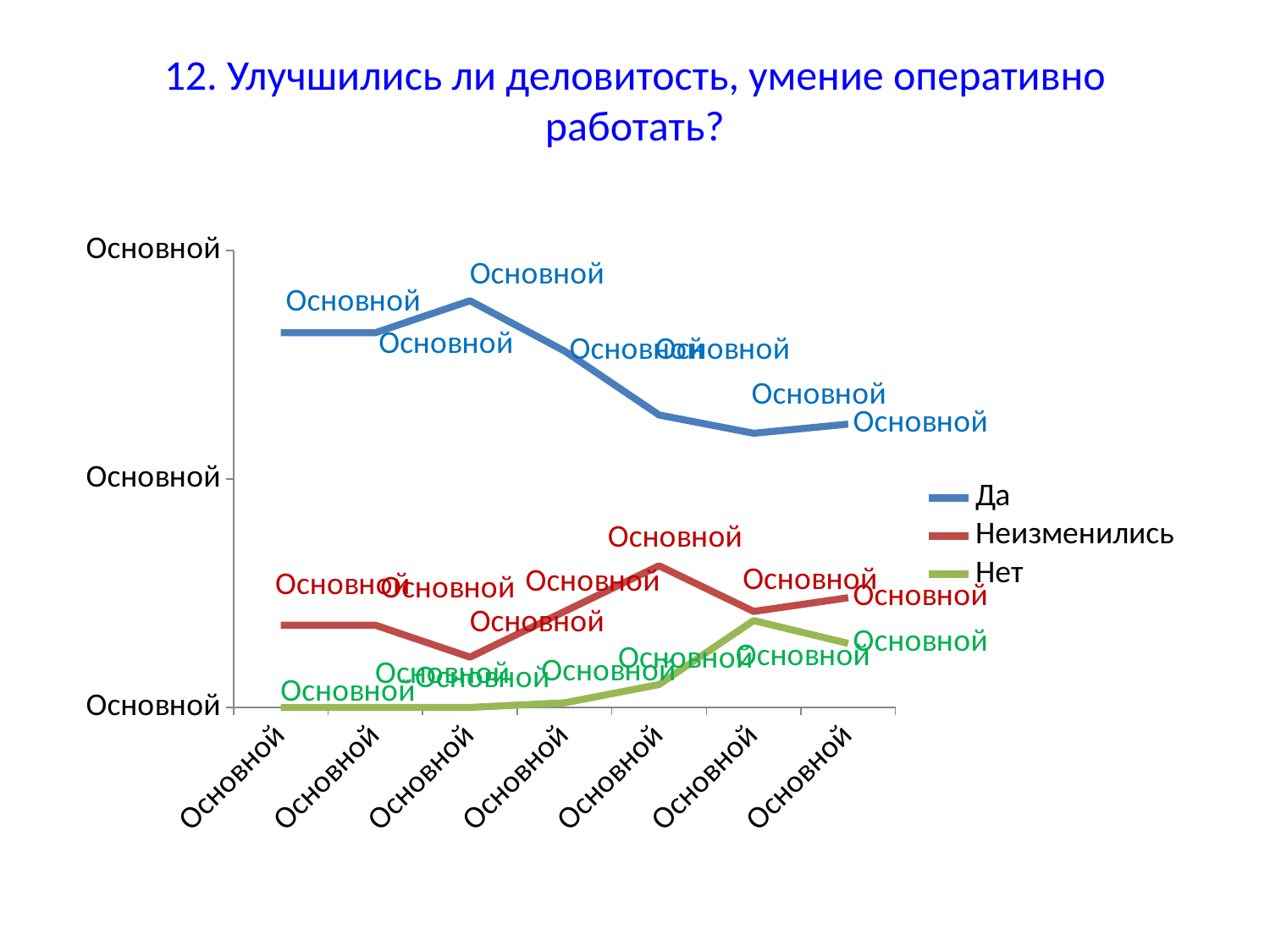
How many data points does each line have? 7 Which series has the lowest values across the chart? Нет What are the series names listed in the legend? Да, Неизменились, Нет How many series does the legend list? 3 Does the line for Да rise or fall overall from left to right? fall Does the line for Нет rise or fall overall from left to right? rise At the first point on the x axis, which is larger: Неизменились or Нет? Неизменились At the last point on the x axis, which is larger: Да or Неизменились? Да Which series has the highest values across the chart? Да What is the title of the slide above the chart? 12. Улучшились ли деловитость, умение оперативно работать? Which series is drawn in green? Нет What kind of chart is shown on the slide? line chart